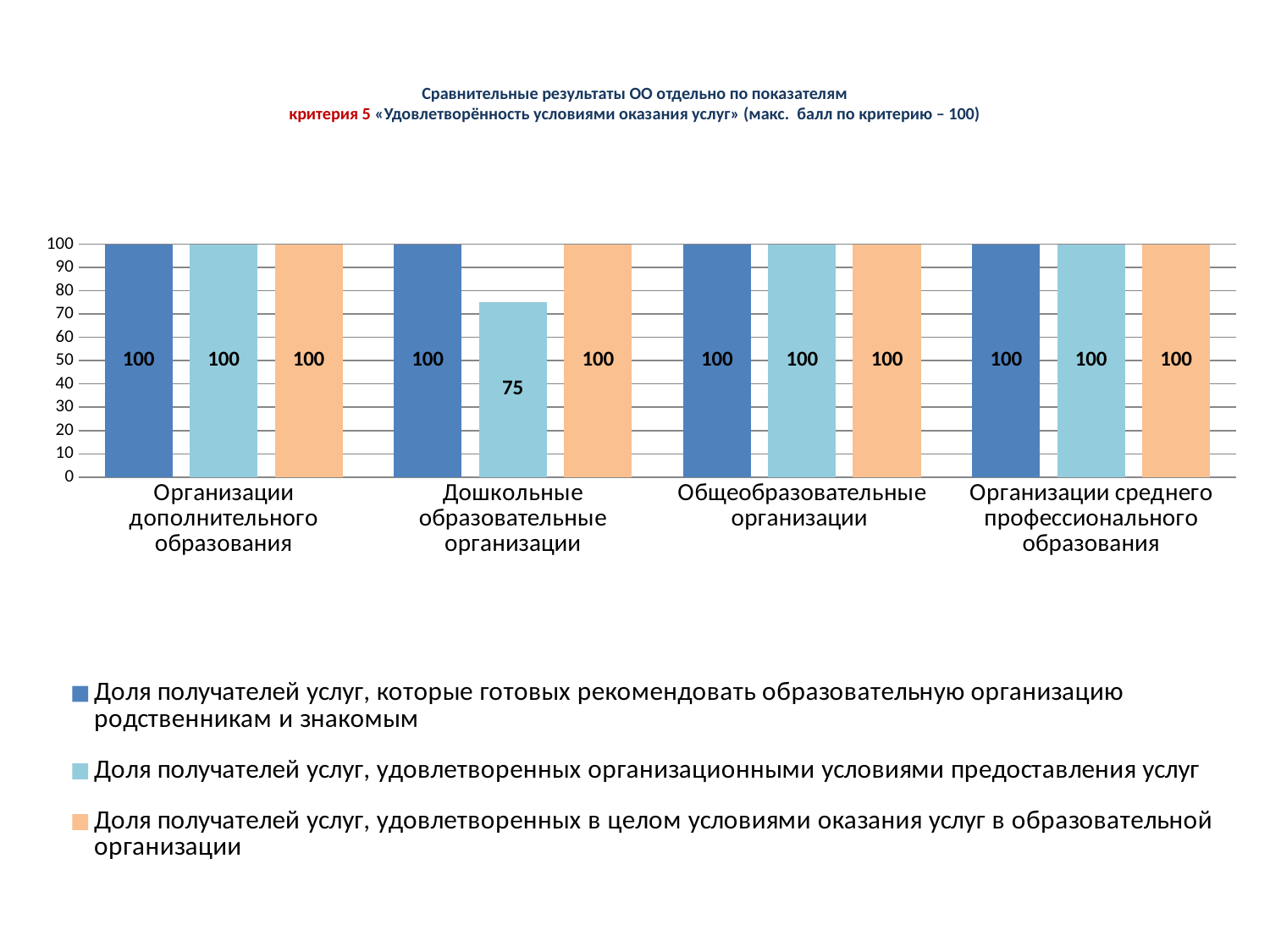
What kind of chart is shown on the slide? bar chart What value is shown for 'Доля получателей услуг, которые готовых рекомендовать образовательную организацию родственникам и знакомым' in the 'Организации дополнительного образования' category? 100 How many categories are shown on the x axis of the chart? 4 How many series does the legend list? 3 What value is shown for 'Доля получателей услуг, удовлетворенных организационными условиями предоставления услуг' in the 'Дошкольные образовательные организации' category? 75 In the 'Дошкольные образовательные организации' category, which is larger: the value for 'Доля получателей услуг, которые готовых рекомендовать образовательную организацию родственникам и знакомым' or the value for 'Доля получателей услуг, удовлетворенных организационными условиями предоставления услуг'? Доля получателей услуг, которые готовых рекомендовать образовательную организацию родственникам и знакомым What colour represents 'Доля получателей услуг, удовлетворенных в целом условиями оказания услуг в образовательной организации' in the legend? orange Which category has the lowest value for 'Доля получателей услуг, удовлетворенных организационными условиями предоставления услуг'? Дошкольные образовательные организации What is the difference between the 'Доля получателей услуг, удовлетворенных организационными условиями предоставления услуг' values for 'Организации дополнительного образования' and 'Дошкольные образовательные организации'? 25 What value is shown for 'Доля получателей услуг, удовлетворенных в целом условиями оказания услуг в образовательной организации' in the 'Общеобразовательные организации' category? 100 What is the maximum value shown on the y axis of the chart? 100 Is the value for 'Доля получателей услуг, удовлетворенных организационными условиями предоставления услуг' in 'Дошкольные образовательные организации' greater or less than 80? less